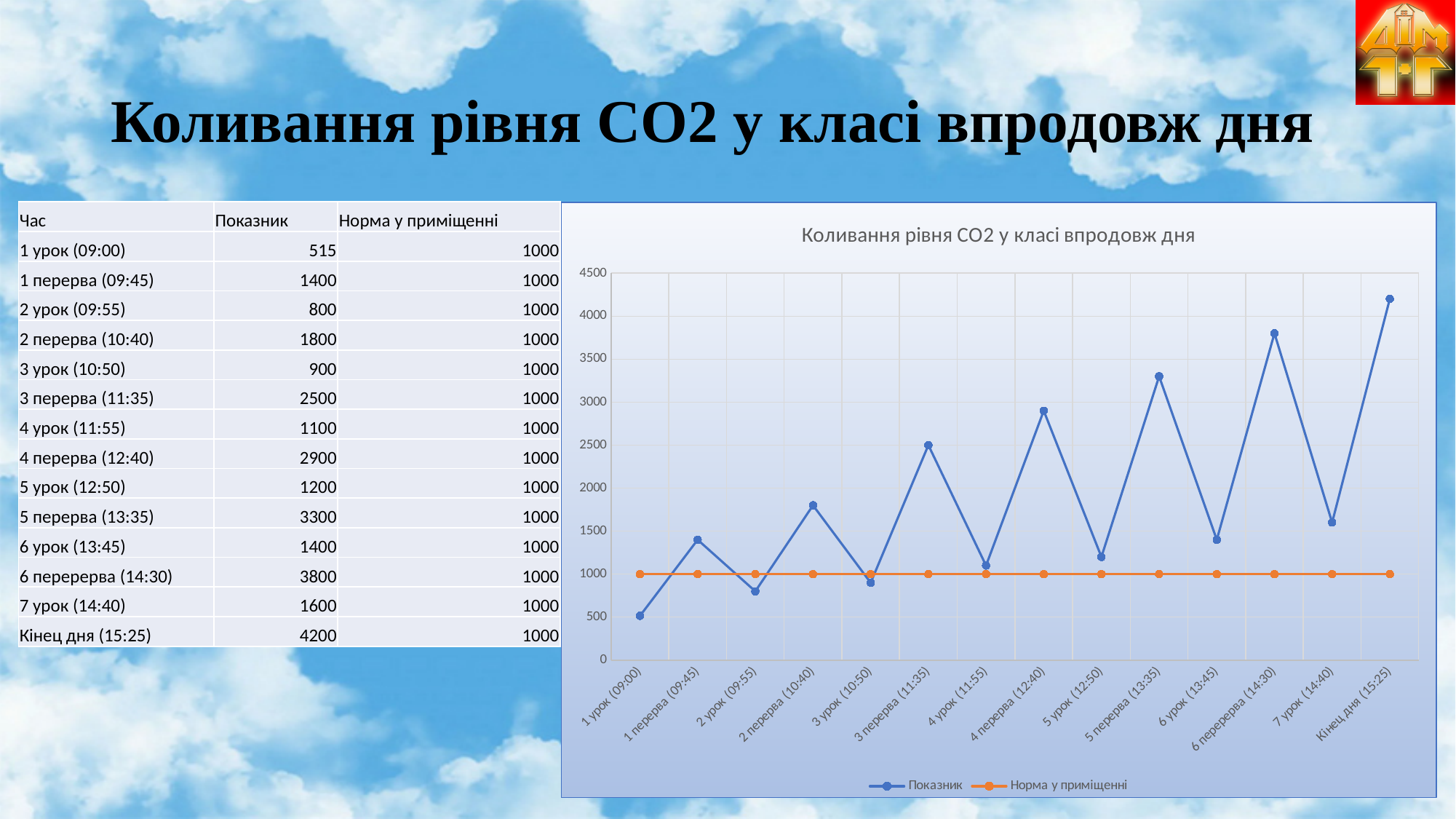
What type of chart is shown on the slide? Line chart At which time point is Показник highest? Кінец дня (15:25) What is the value of Показник at 1 урок (09:00)? 515 What is the title of the chart? Коливання рівня CO2 у класі впродовж дня How many series does the chart legend list? 2 What is the value of Показник at Кінец дня (15:25)? 4200 Which is larger, Показник at 2 перерва (10:40) or at 3 урок (10:50)? 2 перерва (10:40) Is the value of Показник at 5 перерва (13:35) greater or less than 3000? greater How many time points are plotted along the x axis of the chart? 14 What is the value of Норма у приміщенні at 3 перерва (11:35)? 1000 At which time point is Показник lowest? 1 урок (09:00) What is the difference between Показник at 6 перерерва (14:30) and at 7 урок (14:40)? 2200